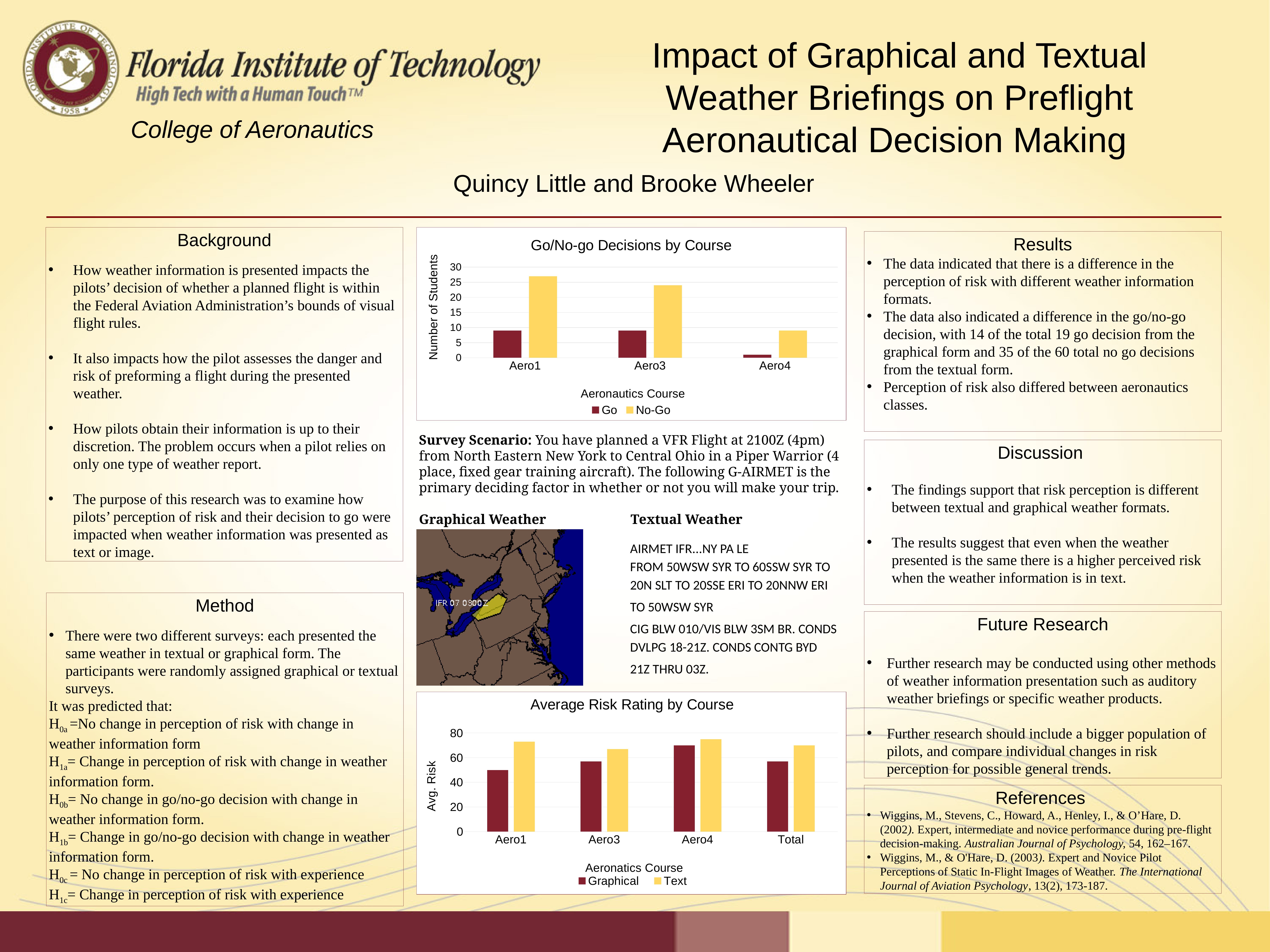
In the 'Go/No-go Decisions by Course' chart, how many series does the legend list? 2 In the 'Average Risk Rating by Course' chart, is the Text value for Aero1 greater or less than 60? greater In the 'Go/No-go Decisions by Course' chart, which course has the highest No-Go value? Aero1 In the 'Go/No-go Decisions by Course' chart, which course has the lowest Go value? Aero4 In the 'Average Risk Rating by Course' chart, how many categories are shown on the x axis? 4 In the 'Go/No-go Decisions by Course' chart, what kind of chart is used? bar chart In the 'Go/No-go Decisions by Course' chart, how many courses are shown on the x axis? 3 In the 'Go/No-go Decisions by Course' chart, is the No-Go value for Aero1 greater or less than 20? greater In the 'Go/No-go Decisions by Course' chart, for Aero3, which is larger: Go or No-Go? No-Go In the 'Average Risk Rating by Course' chart, for Aero1, which is larger: Graphical or Text? Text In the 'Average Risk Rating by Course' chart, what are the two legend entries? Graphical and Text In the 'Average Risk Rating by Course' chart, which category has the lowest Graphical value? Aero1